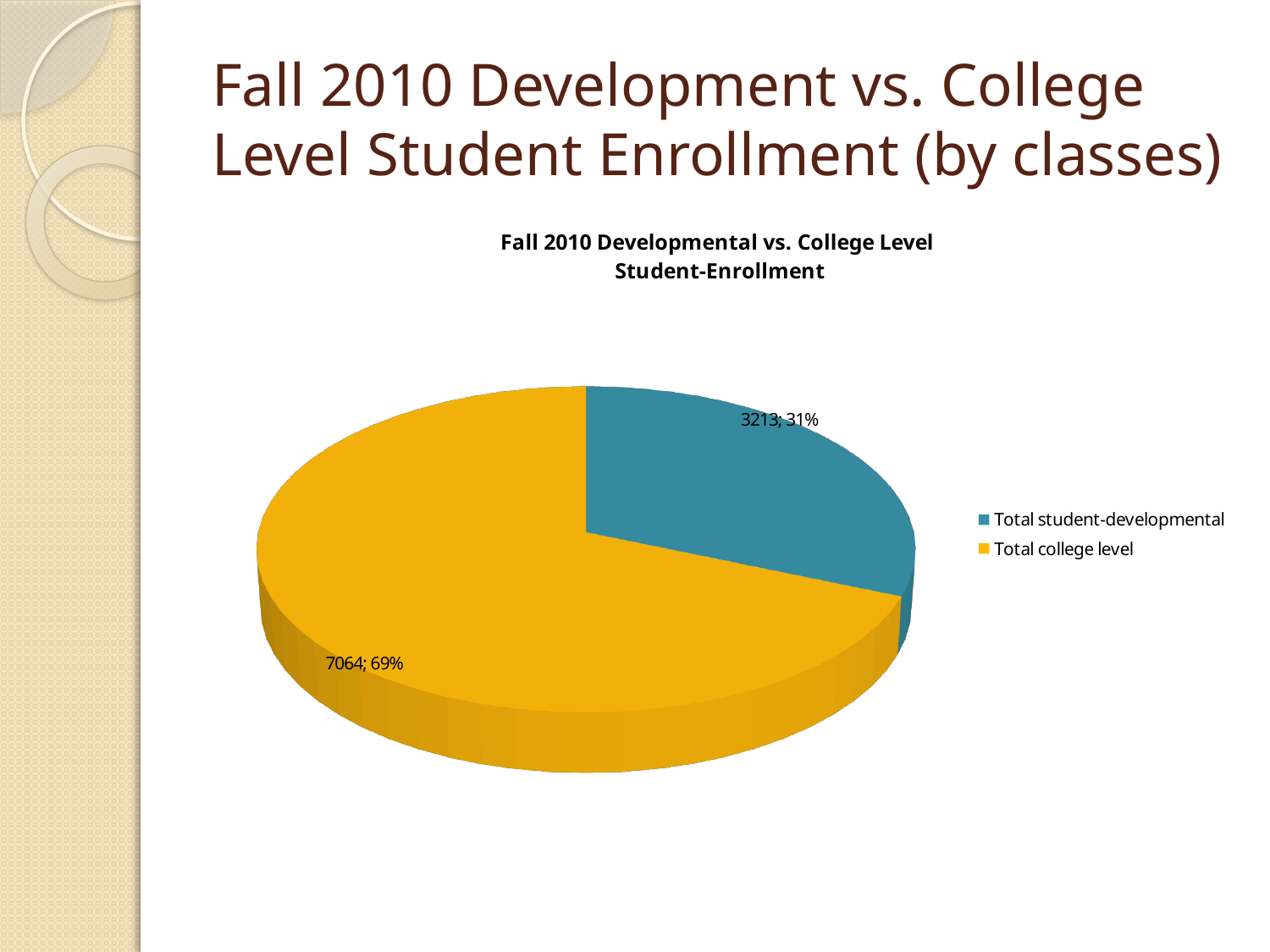
What is the title of the chart? Fall 2010 Developmental vs. College Level Student-Enrollment Which is larger, Total student-developmental or Total college level? Total college level What is the value for Total student-developmental? 3213 What kind of chart is shown on the slide? pie chart What is the total of the two slices in the pie chart? 10277 What is the value for Total college level? 7064 What is the difference between Total college level and Total student-developmental? 3851 Which category has the smallest slice? Total student-developmental What share of the pie does Total student-developmental represent? 31% Which category has the largest slice? Total college level How many slices does the pie chart have? 2 What share of the pie does Total college level represent? 69%